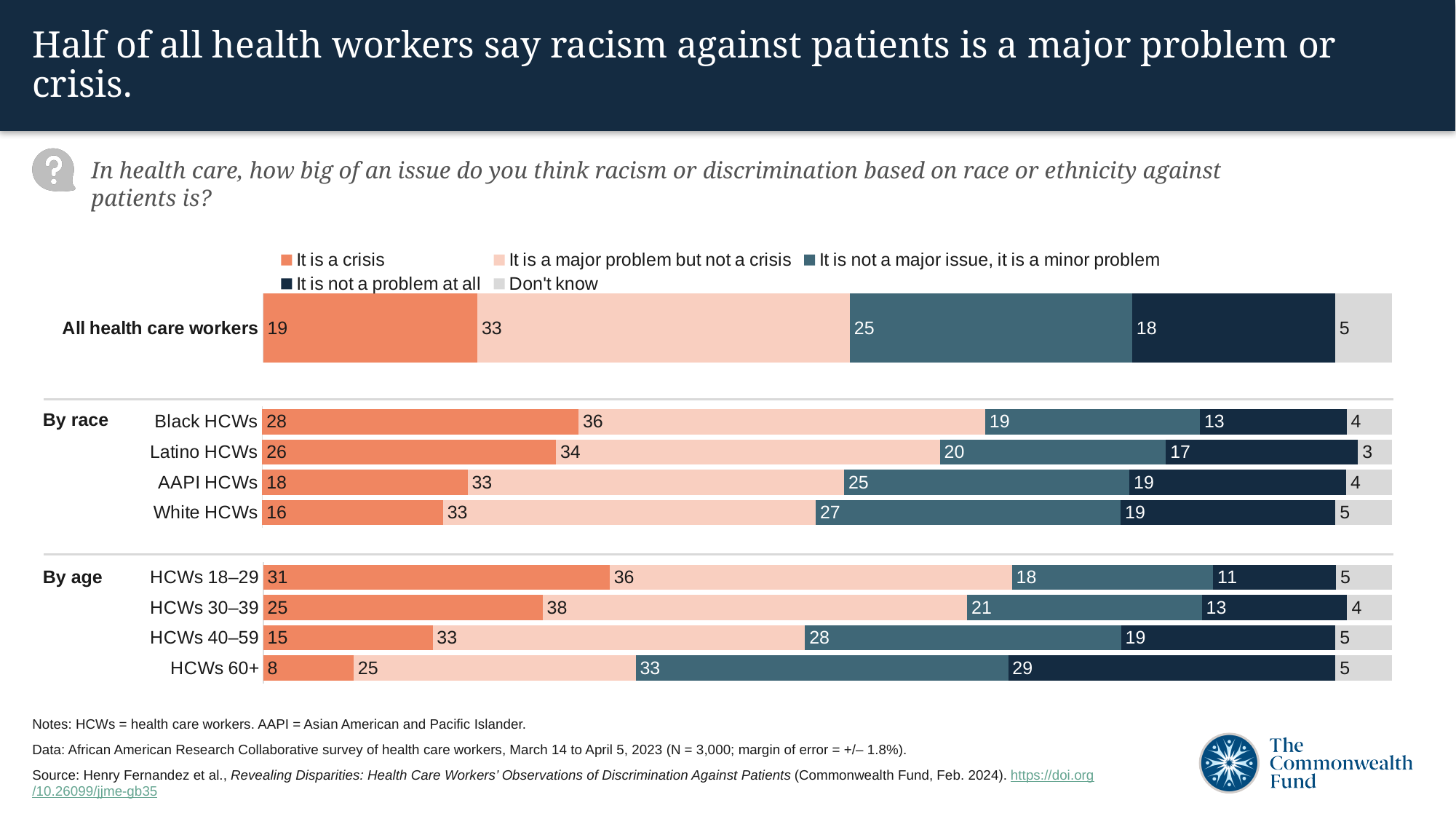
Which has a larger "It is not a problem at all" value, Black HCWs or Latino HCWs? Latino HCWs What is the value for "It is not a major issue, it is a minor problem" among HCWs 60+? 33 Which group has the lowest value for "It is a crisis"? HCWs 60+ How many groups (bars) are shown in the chart? 9 What is the "Don't know" value for Latino HCWs? 3 Which group has the highest value for "It is a crisis"? HCWs 18–29 How many response categories does the legend list? 5 What colour represents "It is a crisis" in the chart? Orange What percentage of Black HCWs say it is a crisis? 28 How much larger is the "It is a major problem but not a crisis" value for HCWs 30–39 than for HCWs 60+? 13 What type of chart is shown on the slide? Stacked bar chart What is the total of the segments in the "All health care workers" bar? 100